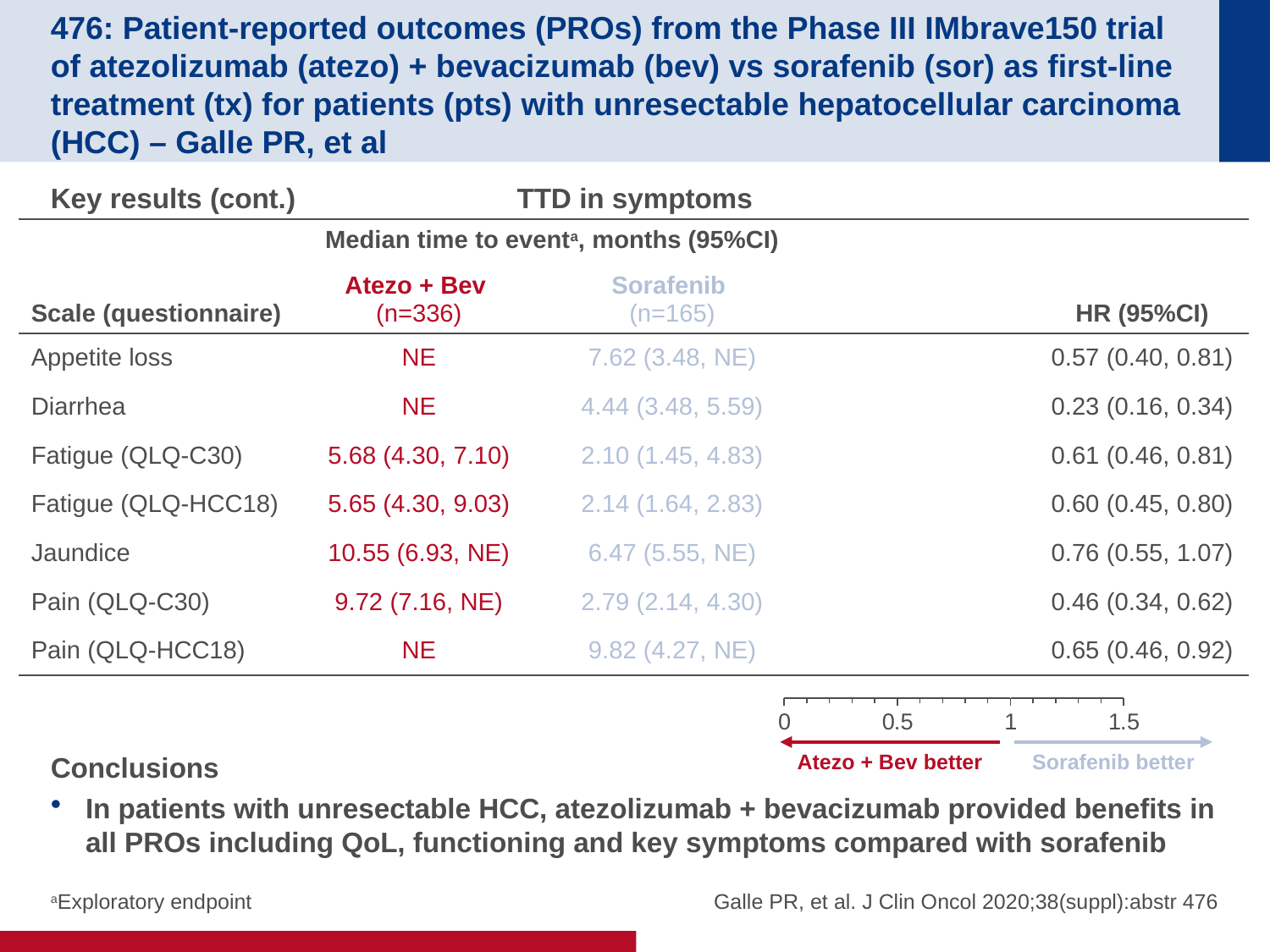
What is the median time to event for Jaundice in the Atezo + Bev arm? 10.55 (6.93, NE) What is the difference between the hazard ratio for Jaundice and the hazard ratio for Diarrhea? 0.53 What is the HR (95%CI) for Diarrhea in the forest plot table? 0.23 (0.16, 0.34) Which side of the hazard ratio axis is labelled 'Atezo + Bev better'? Left What is the HR (95%CI) for Jaundice? 0.76 (0.55, 1.07) How many scales (questionnaires) are listed in the TTD in symptoms table? 7 What is the median time to event for Pain (QLQ-C30) in the Sorafenib arm? 2.79 (2.14, 4.30) Which scale has the highest hazard ratio? Jaundice What is the highest tick value shown on the hazard ratio axis? 1.5 Which has the larger hazard ratio, Fatigue (QLQ-C30) or Pain (QLQ-C30)? Fatigue (QLQ-C30) Which scale has the lowest hazard ratio? Diarrhea Is the hazard ratio for Appetite loss greater or less than 1? less